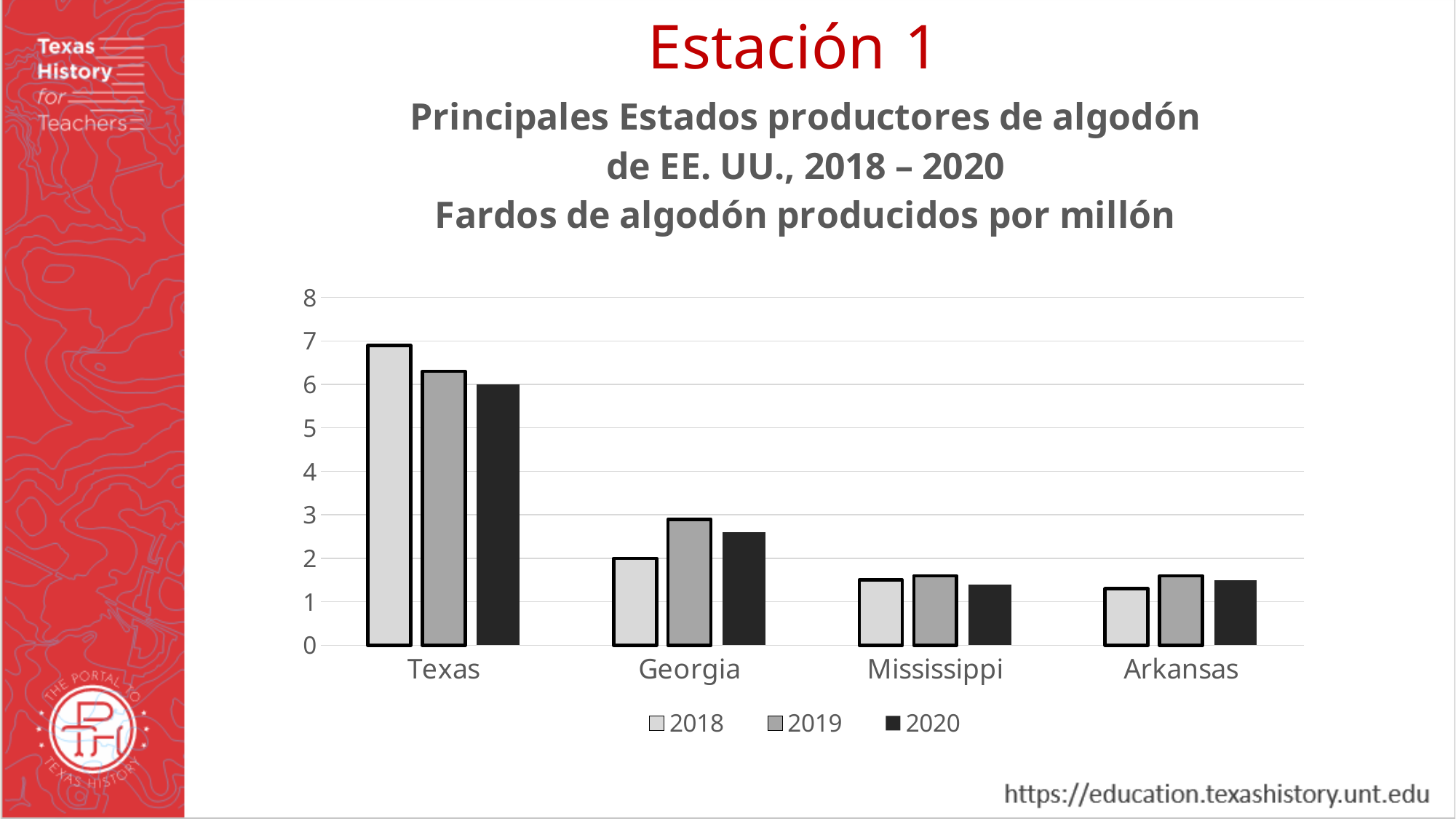
How many states are shown on the x axis? 4 Is the value for Arkansas in 2020 greater or less than 2? less For Georgia, which year has the larger value, 2018 or 2019? 2019 How many series does the legend list? 3 Is the value for Texas in 2018 greater or less than 6? greater What are the entries in the chart's legend? 2018, 2019, 2020 Do the values for Texas rise or fall from 2018 to 2020? fall For Texas, which year has the larger value, 2018 or 2020? 2018 Which state has the highest value for 2018? Texas What kind of chart is shown on the slide? bar chart Is the value for Georgia in 2019 greater or less than 3? less Which state has the lowest value for 2018? Arkansas